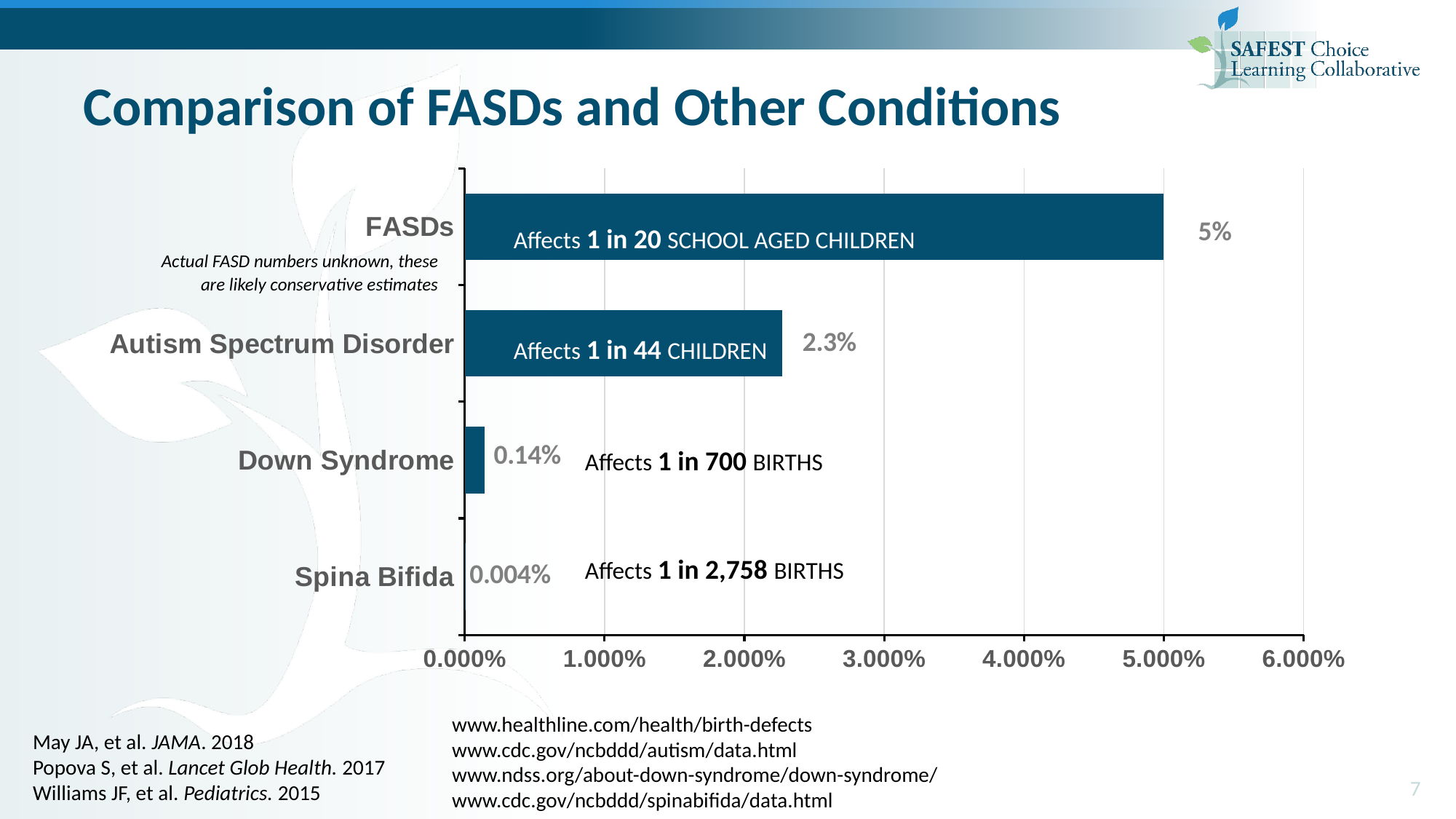
What is the value for Down Syndrome? 0.14% Which is larger, the value for Autism Spectrum Disorder or the value for Down Syndrome? Autism Spectrum Disorder Is the value for Autism Spectrum Disorder greater or less than 2.000%? greater Which condition has the lowest value? Spina Bifida What is the value for Spina Bifida? 0.004% What is the value for Autism Spectrum Disorder? 2.3% What is the title of the slide? Comparison of FASDs and Other Conditions What is the difference between the values for FASDs and Autism Spectrum Disorder? 2.7% What kind of chart is shown on the slide? bar chart What is the value for FASDs? 5% How many conditions are shown in the chart? 4 Which condition has the highest value? FASDs